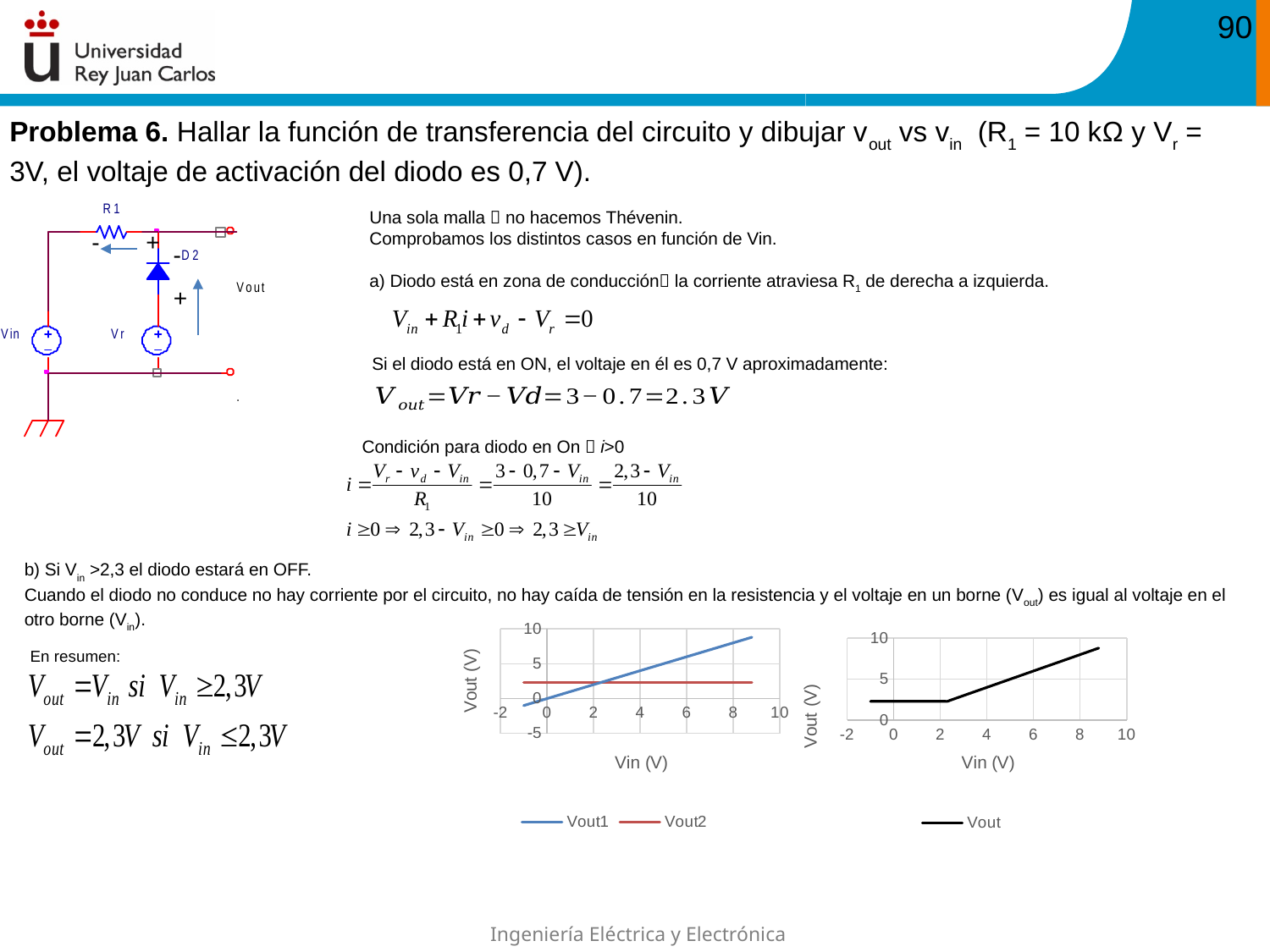
In the left chart, at Vin = 8, which series has the larger value, Vout1 or Vout2? Vout1 In the left chart, does the Vout2 series rise, fall, or stay flat as Vin increases? stay flat How many series does the legend of the left chart list? 2 In the left chart, does the Vout1 series rise or fall as Vin increases? rise In the left chart, is the value of Vout2 at Vin = 8 greater or less than 5? less What kind of chart is the left chart at the bottom of the slide? line chart What kind of chart is the right chart at the bottom of the slide? line chart How many series does the legend of the right chart list? 1 What is the x-axis title of the right chart? Vin (V) In the left chart, what are the names of the two series in the legend? Vout1 and Vout2 In the left chart, is the value of Vout1 at Vin = 8 greater or less than 5? greater In the right chart, is the value of Vout at Vin = 0 greater or less than 5? less